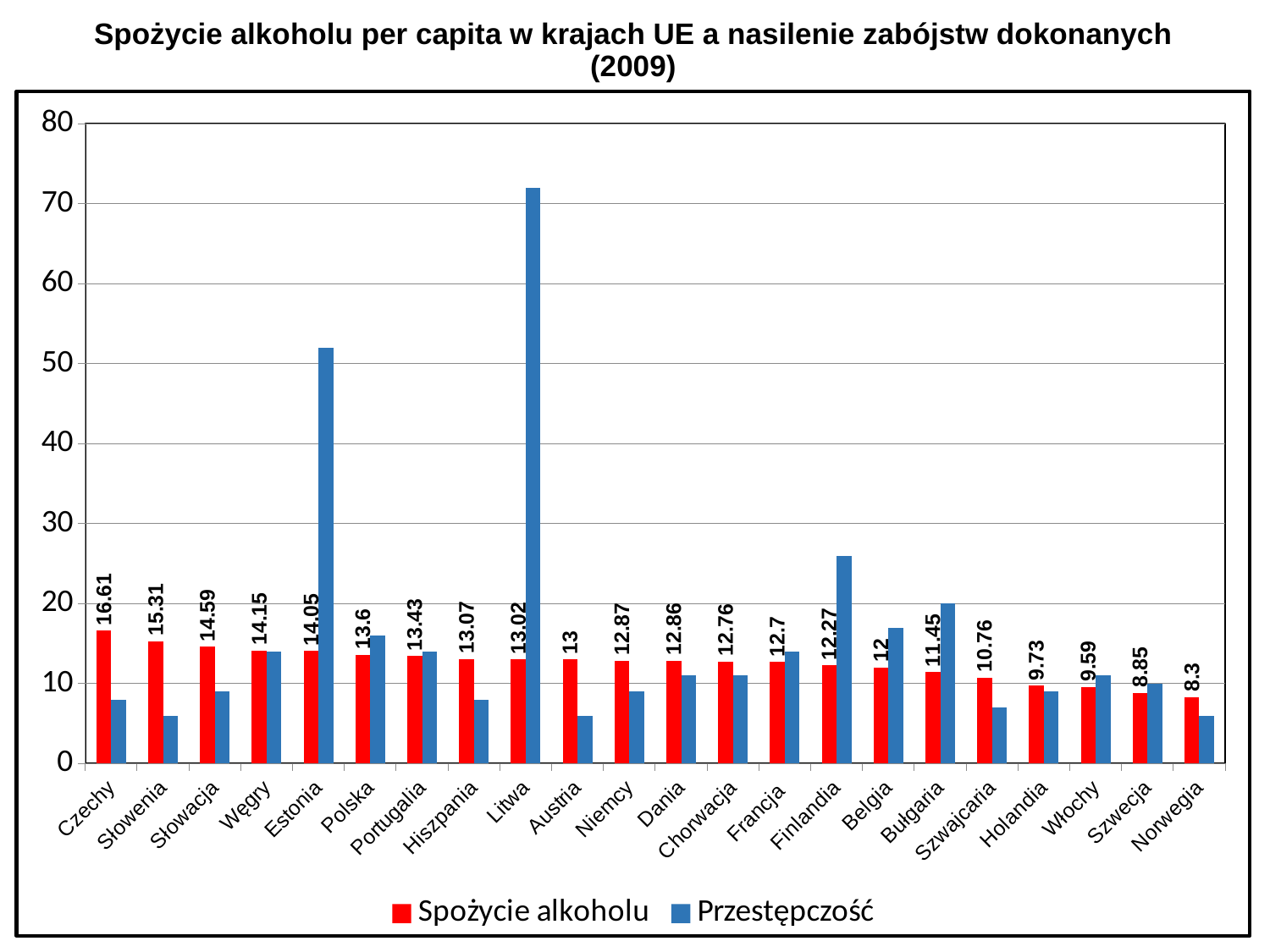
Which country has the lowest Spożycie alkoholu value? Norwegia Is the Przestępczość value for Estonia greater or less than 40? greater Which is larger for Finlandia: the Spożycie alkoholu value or the Przestępczość value? Przestępczość What type of chart is shown on the slide? bar chart What is the Spożycie alkoholu value for Polska? 13.6 How many series does the legend list? 2 What is the difference between the Spożycie alkoholu values for Czechy and Norwegia? 8.31 Which country has the highest Spożycie alkoholu value? Czechy Which country has the highest Przestępczość value? Litwa How many countries are shown on the x axis? 22 What is the Spożycie alkoholu value for Finlandia? 12.27 Do the Spożycie alkoholu values rise or fall from left to right along the x axis? fall